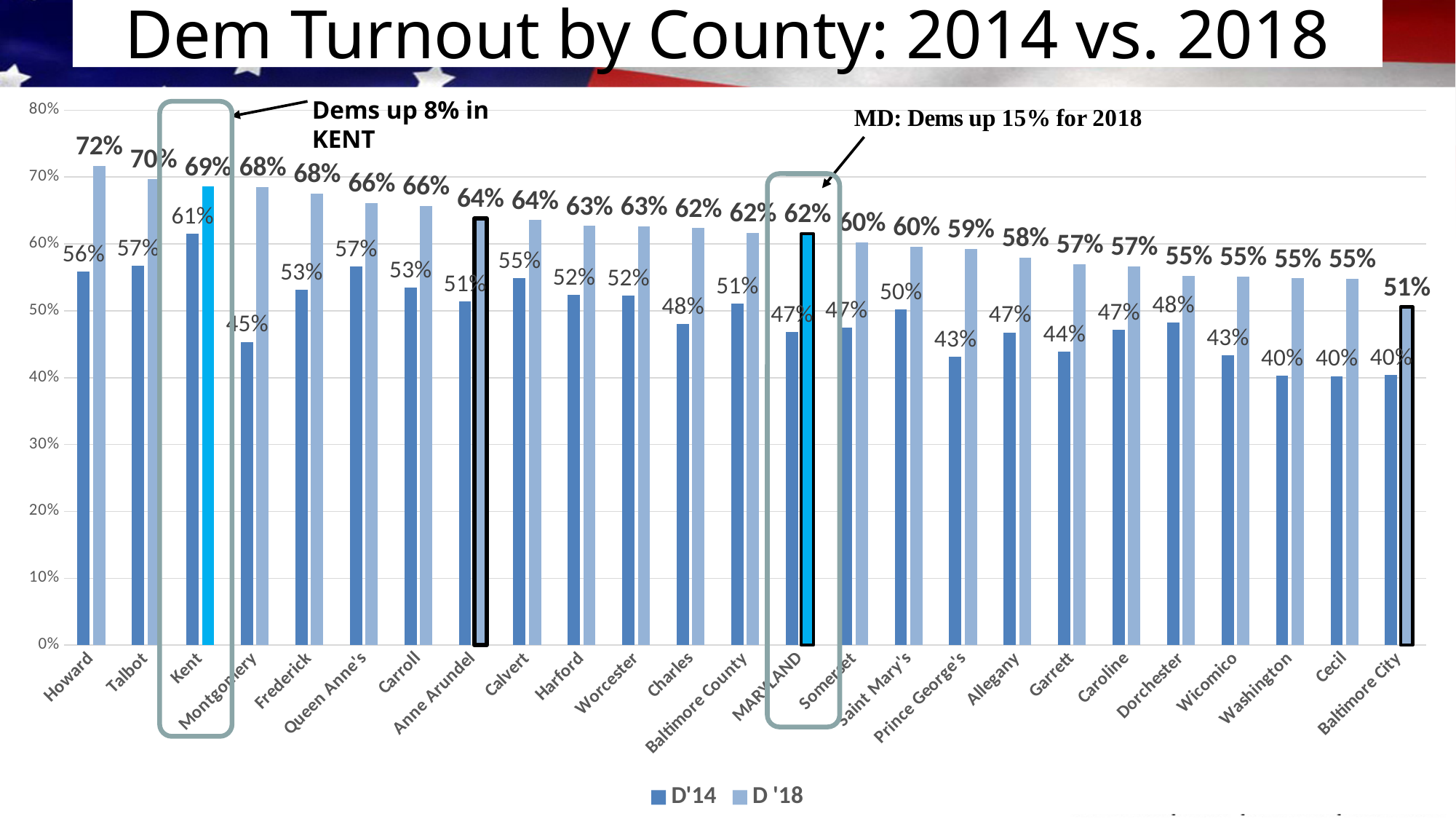
How many categories are shown on the x axis? 25 Is the D'14 value for Baltimore City greater or less than 50%? less What is the D '18 value for MARYLAND? 62% Which category has the lowest D '18 value? Baltimore City What is the D'14 value for Montgomery? 45% What is the difference between the D '18 and D'14 values for Montgomery? 23 percentage points What is the D '18 value for Howard? 72% Which is larger, the D'14 value for Kent or the D'14 value for Talbot? Kent What are the two legend entries of the chart? D'14 and D '18 How many series does the legend list? 2 What kind of chart is shown on the slide? bar chart Which county has the highest D '18 value? Howard